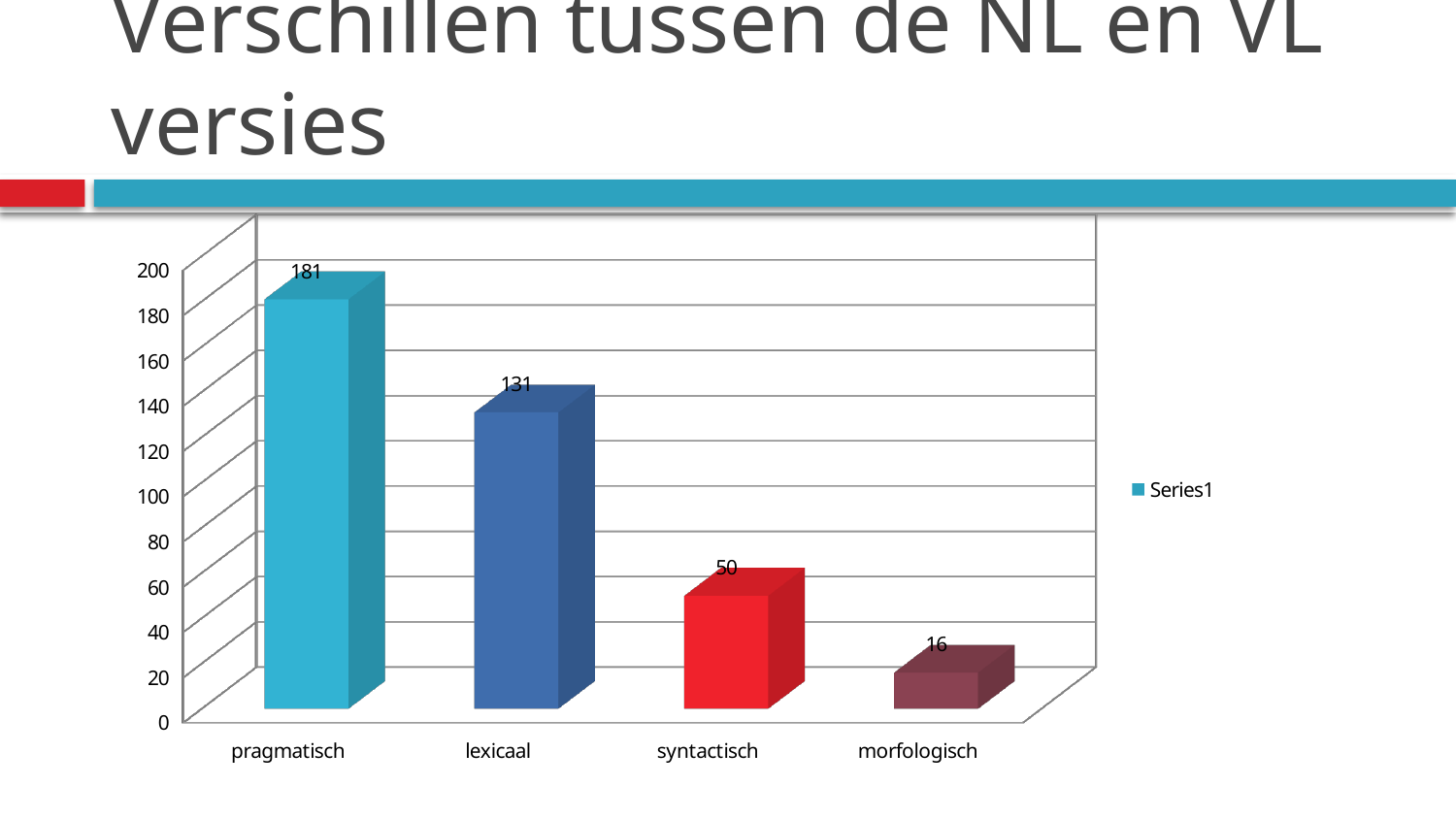
What kind of chart is shown on the slide? bar chart Which category has the highest value? pragmatisch How many categories are shown on the x axis? 4 How many series does the legend list? 1 What is the value for morfologisch? 16 Which category has the lowest value? morfologisch Which is larger, the value for lexicaal or the value for syntactisch? lexicaal What is the value for syntactisch? 50 What is the difference between the values for syntactisch and morfologisch? 34 What is the value for pragmatisch? 181 What is the value for lexicaal? 131 What is the difference between the values for pragmatisch and lexicaal? 50